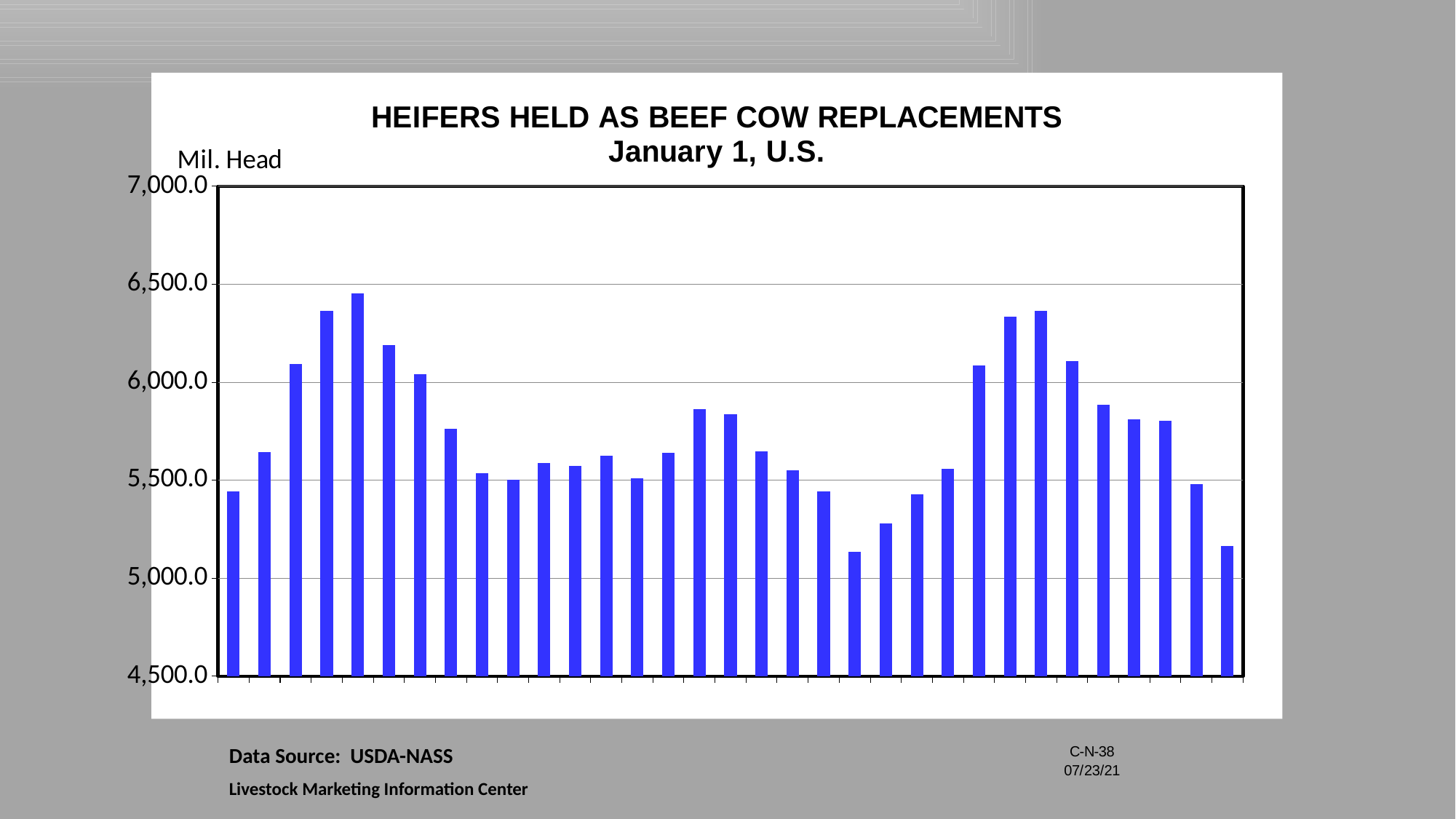
Is the value of the tallest bar greater or less than 6,000.0? greater How many bars are plotted in the chart? 33 Is the value of the last (rightmost) bar greater or less than 5,500.0? less Do the values rise or fall over the last three bars of the chart? fall Is the value of the first (leftmost) bar greater or less than 5,000.0? greater What kind of chart is shown on the slide? bar chart Counting from the left, which bar is the tallest in the chart? the fifth bar What is the title of the chart? HEIFERS HELD AS BEEF COW REPLACEMENTS January 1, U.S. Which is larger, the first (leftmost) bar or the last (rightmost) bar? the first (leftmost) bar Do the values rise or fall from the first bar to the fifth bar? rise What unit label is shown above the y axis of the chart? Mil. Head